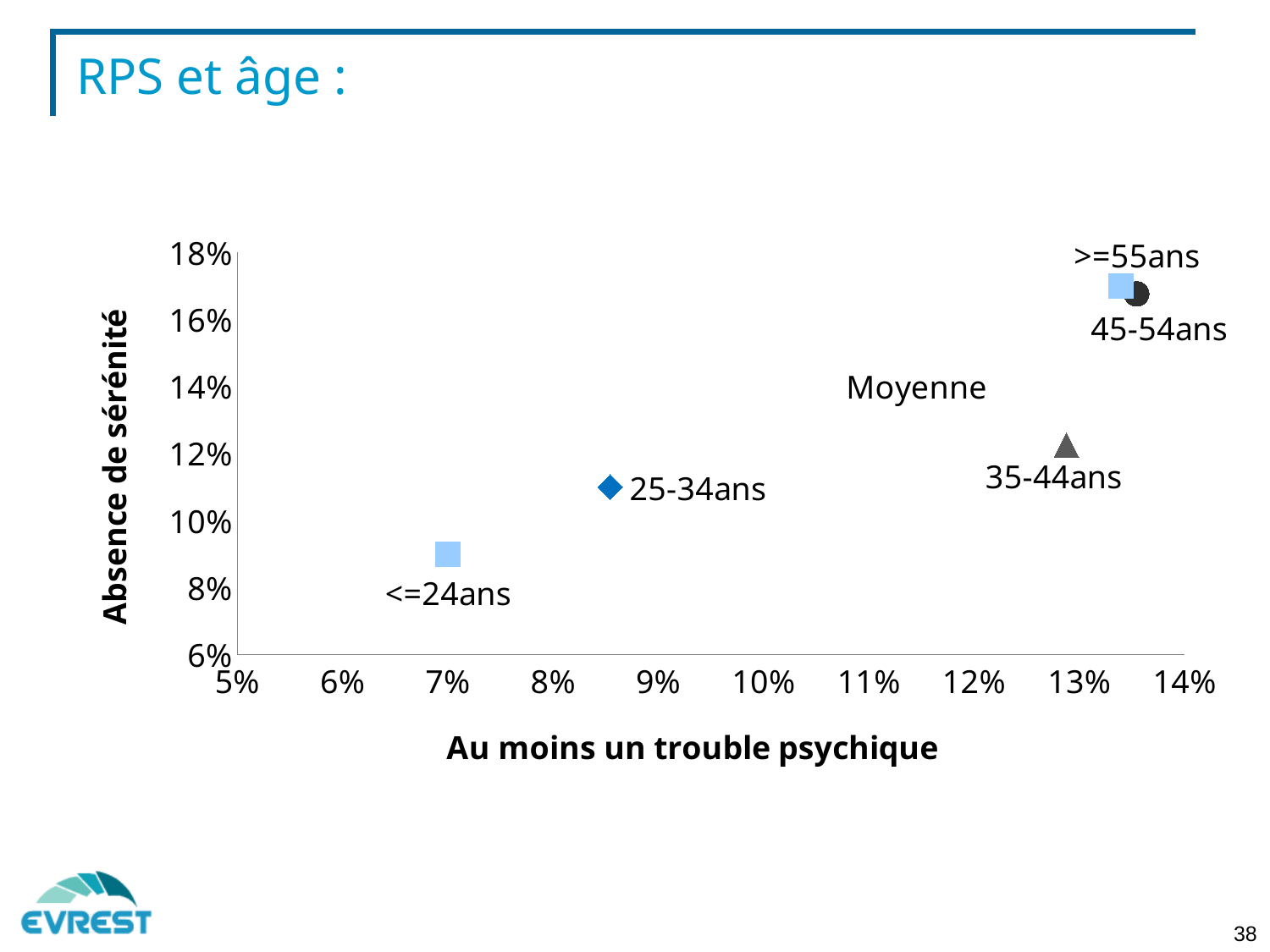
What is the title of the vertical axis? Absence de sérénité Which has the higher 'Absence de sérénité' value, 35-44ans or 45-54ans? 45-54ans What is the title of the horizontal axis? Au moins un trouble psychique How many age groups are labelled as points on the chart? 5 What kind of chart is shown on the slide? scatter chart Is the 'Absence de sérénité' value for 45-54ans greater or less than 16%? greater As 'Au moins un trouble psychique' increases along the x axis, does 'Absence de sérénité' generally rise or fall? rise Which age group has the lowest value for 'Au moins un trouble psychique'? <=24ans Which age group has the lowest value for 'Absence de sérénité'? <=24ans Is the 'Absence de sérénité' value for <=24ans greater or less than 10%? less Is the 'Absence de sérénité' value for 25-34ans greater or less than 10%? greater